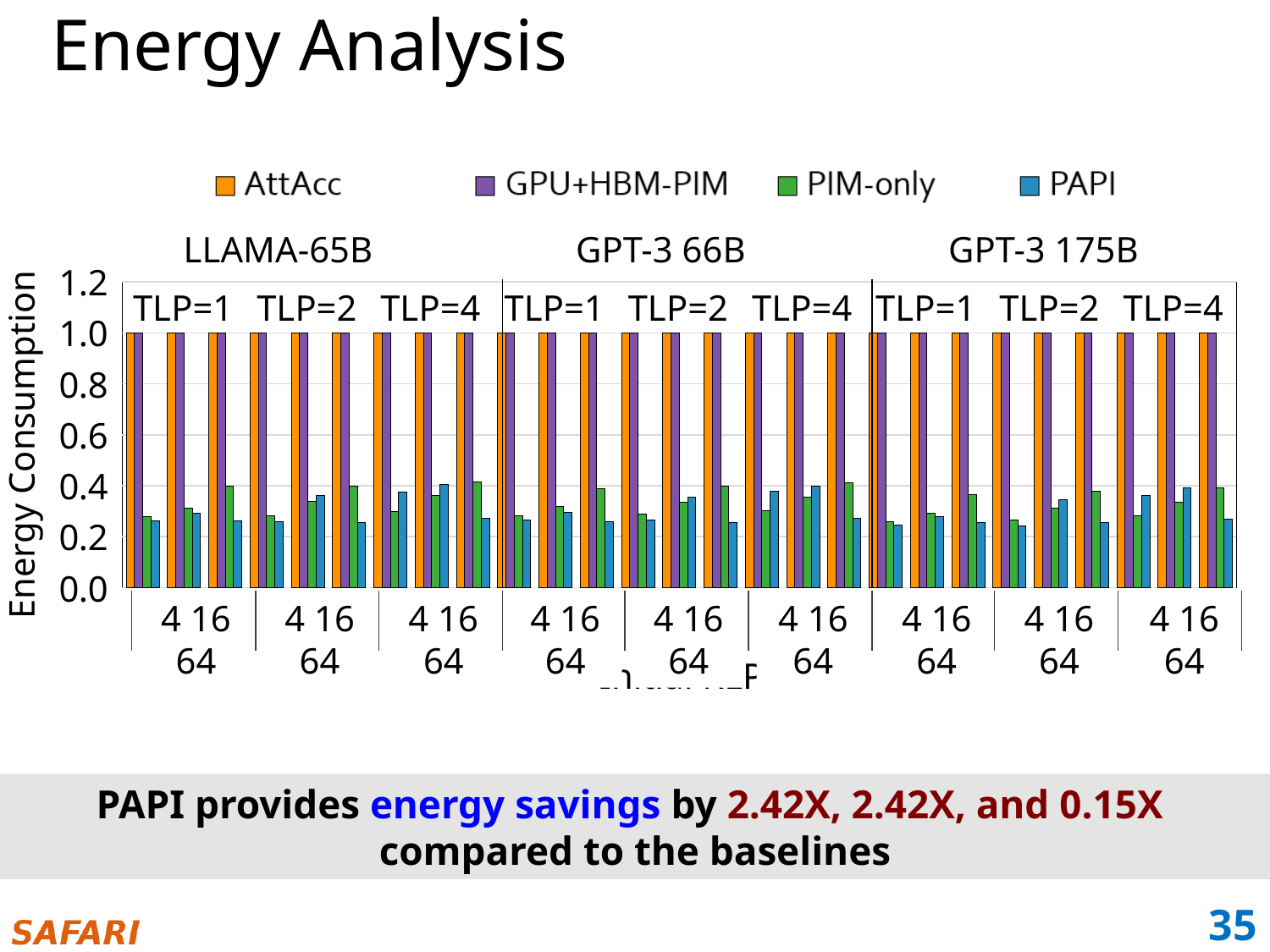
For LLAMA-65B at TLP=1, do the PIM-only bars rise or fall as batch size increases from 4 to 64? rise How many series does the legend list? 4 Which is larger at LLAMA-65B, TLP=1, batch size 4: the AttAcc bar or the PAPI bar? AttAcc What kind of chart is shown on the slide? bar chart Is the value for PIM-only at LLAMA-65B, TLP=4, batch size 64 greater or less than 0.8? less What is the energy consumption value for AttAcc at LLAMA-65B, TLP=1, batch size 4? 1.0 What are the four series named in the legend? AttAcc, GPU+HBM-PIM, PIM-only, PAPI What is the label of the y axis? Energy Consumption Which series has the lowest bar at LLAMA-65B, TLP=4, batch size 64? PAPI How many model groups (LLAMA-65B, GPT-3 66B, GPT-3 175B) are shown along the x axis? 3 Is the value for GPU+HBM-PIM at GPT-3 66B, TLP=2, batch size 16 greater or less than 0.8? greater Is the value for PAPI at GPT-3 175B, TLP=1, batch size 4 greater or less than 0.6? less